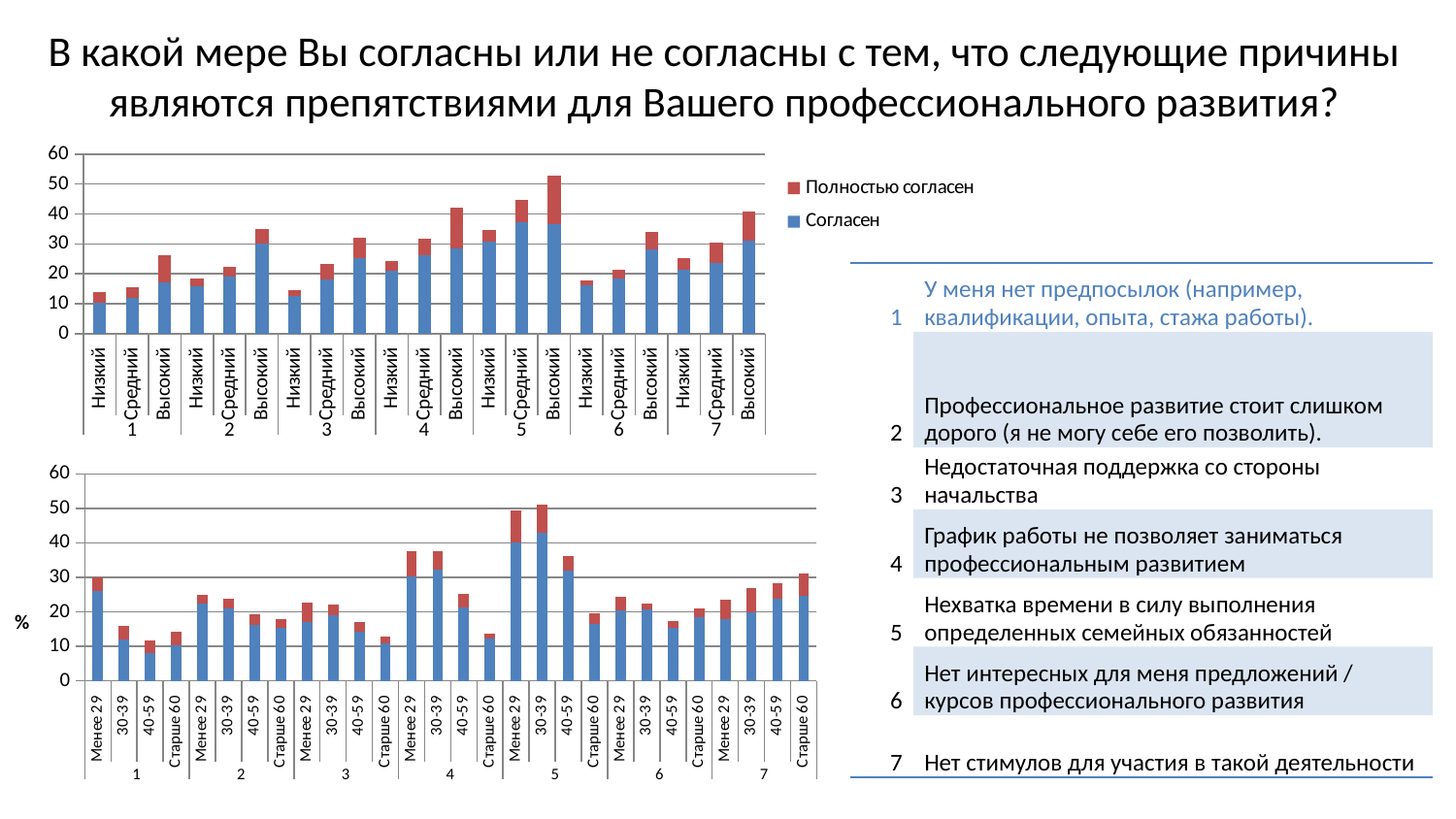
In the top chart, within group 1, do the bar totals rise or fall going from Низкий to Высокий? rise In the top chart, how many numbered groups (1–7) are shown along the x axis? 7 In the bottom chart, how many bars are plotted in total? 28 In the top chart, which bar reaches the highest total? Высокий in group 5 In the bottom chart, is the total for Менее 29 in group 4 greater or less than 30? greater In the bottom chart, is the total for Менее 29 in group 5 greater or less than 40? greater In the top chart, how many bars are plotted in total? 21 What kind of chart is the top chart on the slide? stacked bar chart In the top chart, is the total for Высокий in group 5 greater or less than 50? greater Which colour represents the series "Полностью согласен" in the legend? red How many series does the legend list for the charts? 2